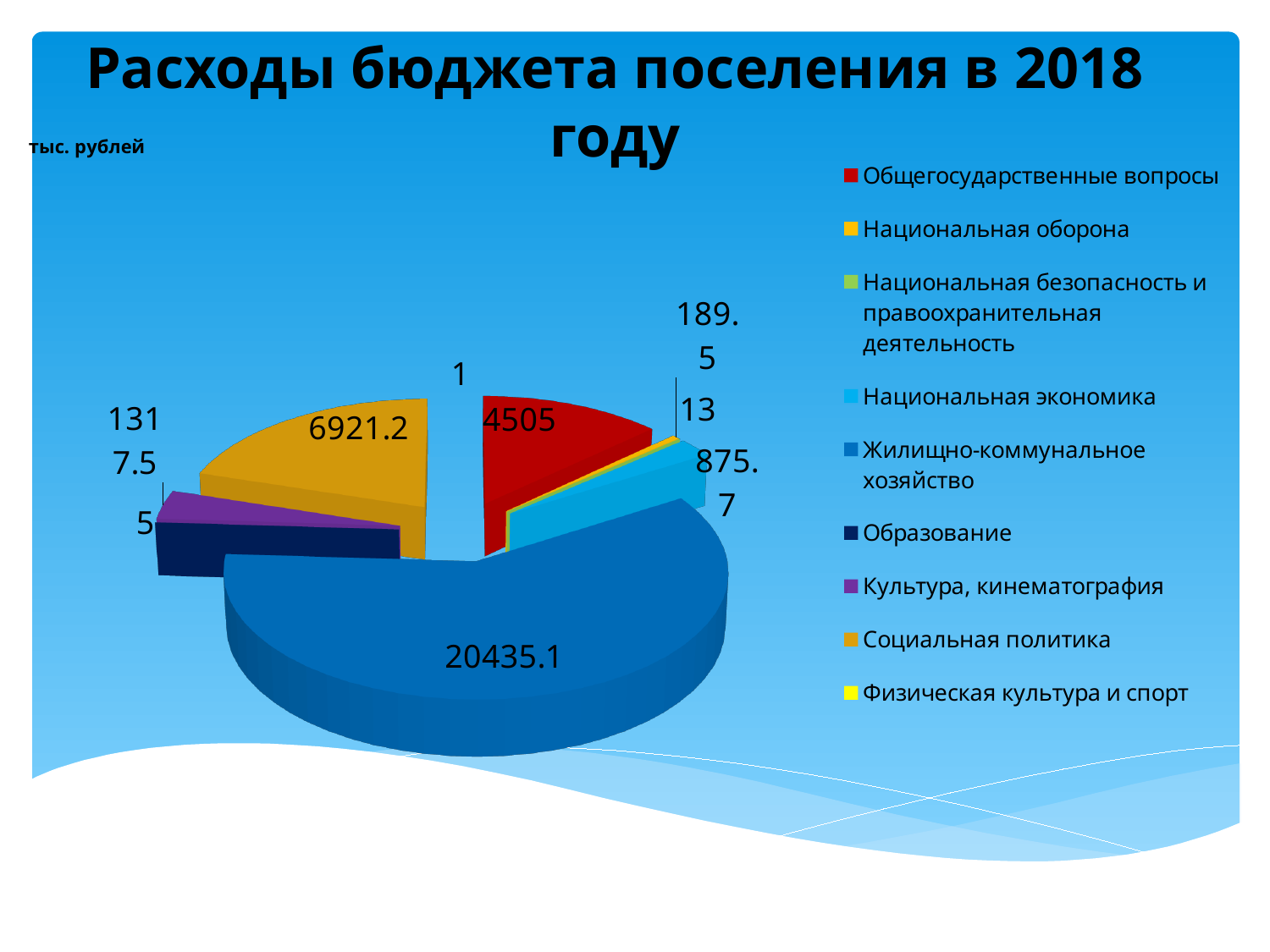
What is the difference between the value for Жилищно-коммунальное хозяйство and the value for Социальная политика? 13513.9 What is the title of the chart? Расходы бюджета поселения в 2018 году What is the value for Жилищно-коммунальное хозяйство? 20435.1 Which is larger, the value for Социальная политика or the value for Общегосударственные вопросы? Социальная политика Which category has the largest slice of the pie? Жилищно-коммунальное хозяйство How many categories does the legend list? 9 What is the value for Социальная политика? 6921.2 What is the value for Общегосударственные вопросы? 4505 In what units are the values given, according to the label at the top left of the chart? тыс. рублей What kind of chart is shown on the slide? pie chart What is the difference between the value for Социальная политика and the value for Общегосударственные вопросы? 2416.2 What is the value for Национальная безопасность и правоохранительная деятельность? 13